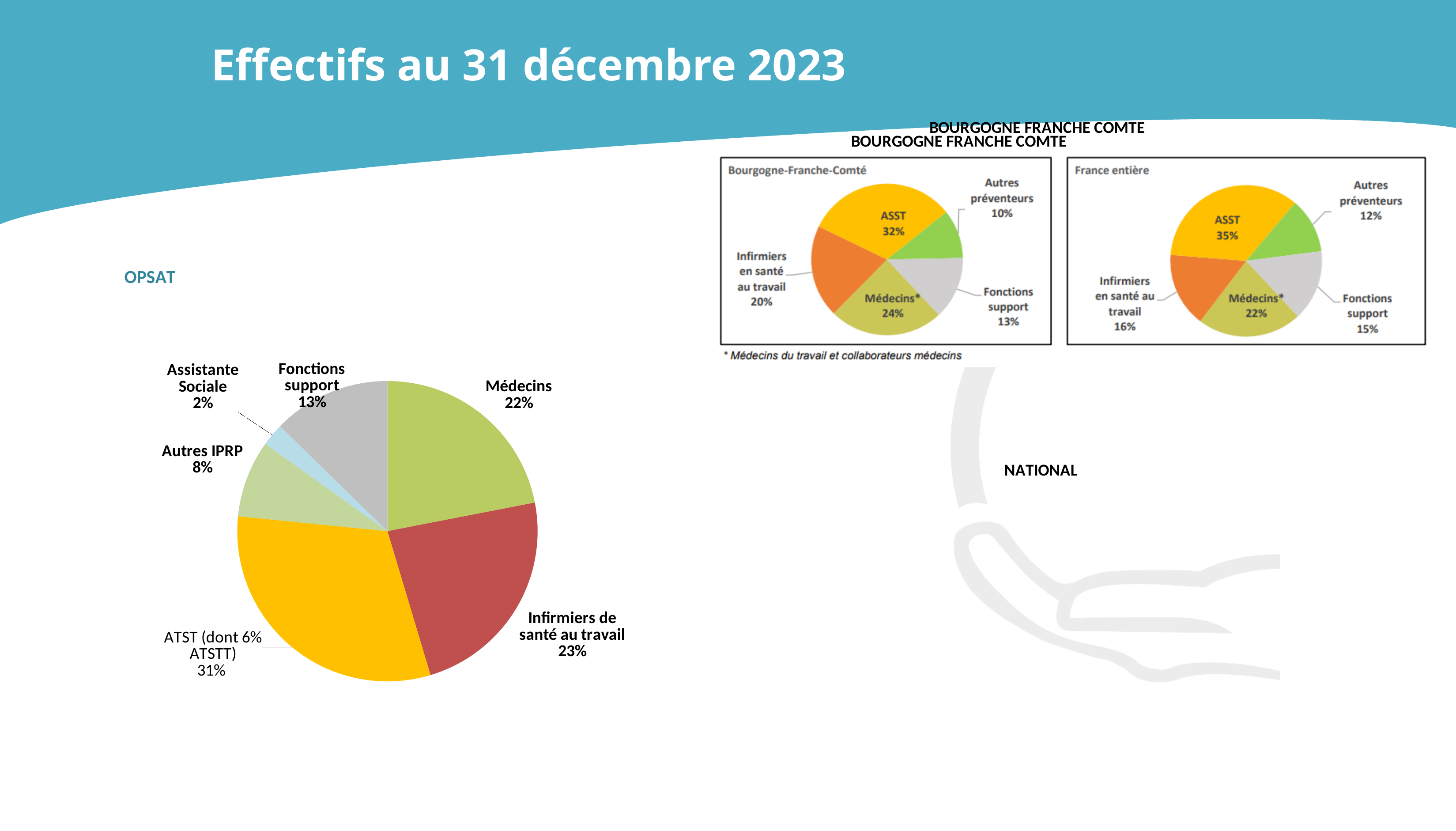
On the France entière pie chart, what share do Infirmiers en santé au travail represent? 16% What kind of chart is the OPSAT chart? Pie chart On the Bourgogne-Franche-Comté pie chart, what share do ASST represent? 32% On the OPSAT pie chart, which category has the largest share? ATST (dont 6% ATSTT) On the OPSAT pie chart, what share do Médecins represent? 22% On the France entière pie chart, which category has the largest share? ASST On the OPSAT pie chart, which category has the smallest share? Assistante Sociale On the Bourgogne-Franche-Comté pie chart, which category has the smallest share? Autres préventeurs On the OPSAT pie chart, what is the difference between the share of Infirmiers de santé au travail and the share of Autres IPRP? 15% Which is larger: the share of Médecins* on the Bourgogne-Franche-Comté pie chart or on the France entière pie chart? Bourgogne-Franche-Comté On the OPSAT pie chart, how many categories are shown? 6 On the France entière pie chart, what is the difference between the share of ASST and the share of Fonctions support? 20%